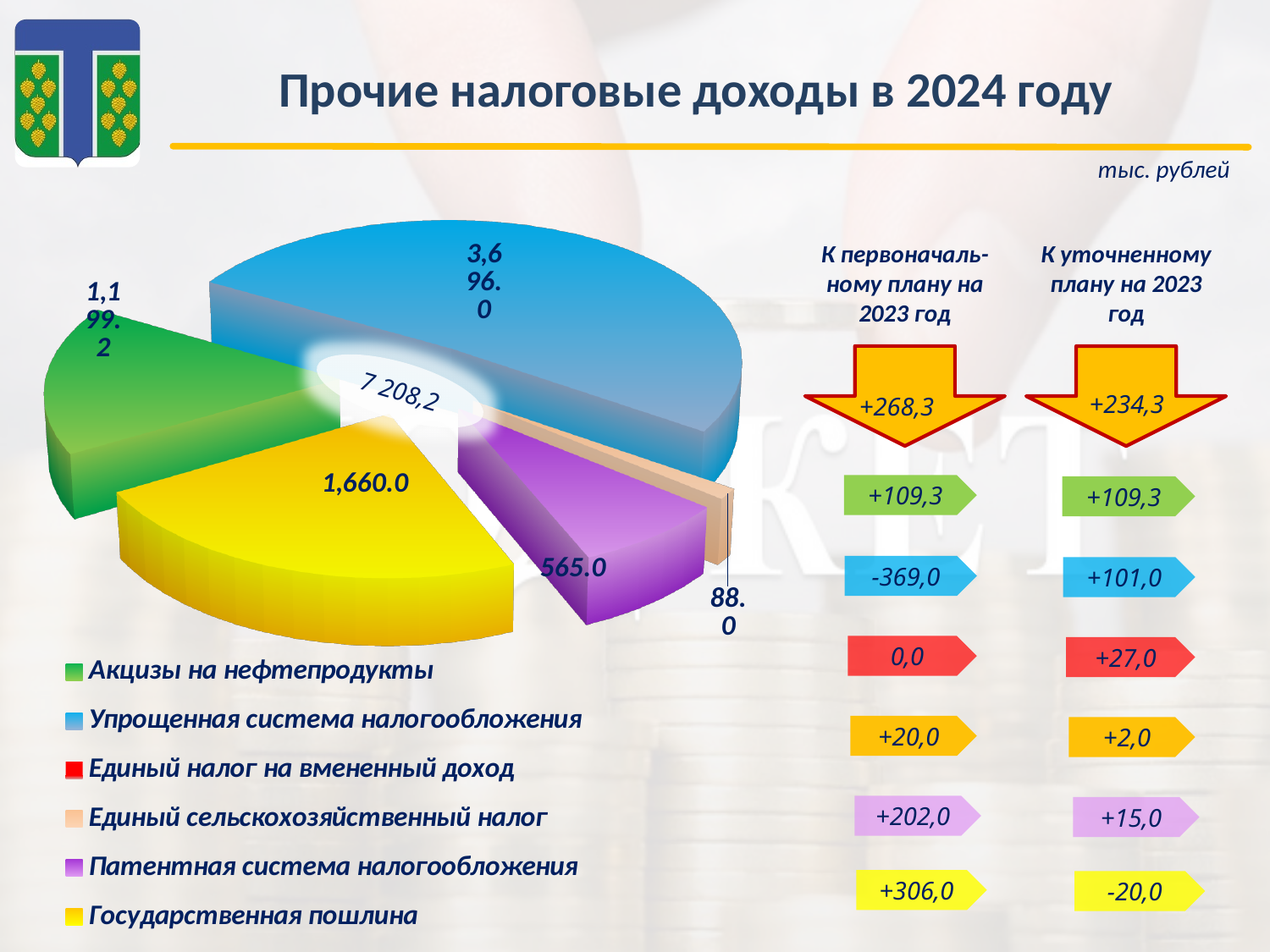
What is the value for Акцизы на нефтепродукты in the pie chart? 1,199.2 What is the value for Патентная система налогообложения in the pie chart? 565.0 What kind of chart is shown on the slide? pie chart Which is larger in the pie chart: Государственная пошлина or Патентная система налогообложения? Государственная пошлина What colour represents Упрощенная система налогообложения in the pie chart? blue What total value is printed in the centre of the pie chart? 7 208,2 What is the value for Единый сельскохозяйственный налог in the pie chart? 88.0 Which category has the largest slice in the pie chart? Упрощенная система налогообложения What is the difference between the values for Государственная пошлина and Патентная система налогообложения? 1,095.0 What is the value for Государственная пошлина in the pie chart? 1,660.0 Which of the labelled slices in the pie chart is the smallest? Единый сельскохозяйственный налог How many entries does the legend of the pie chart list? 6